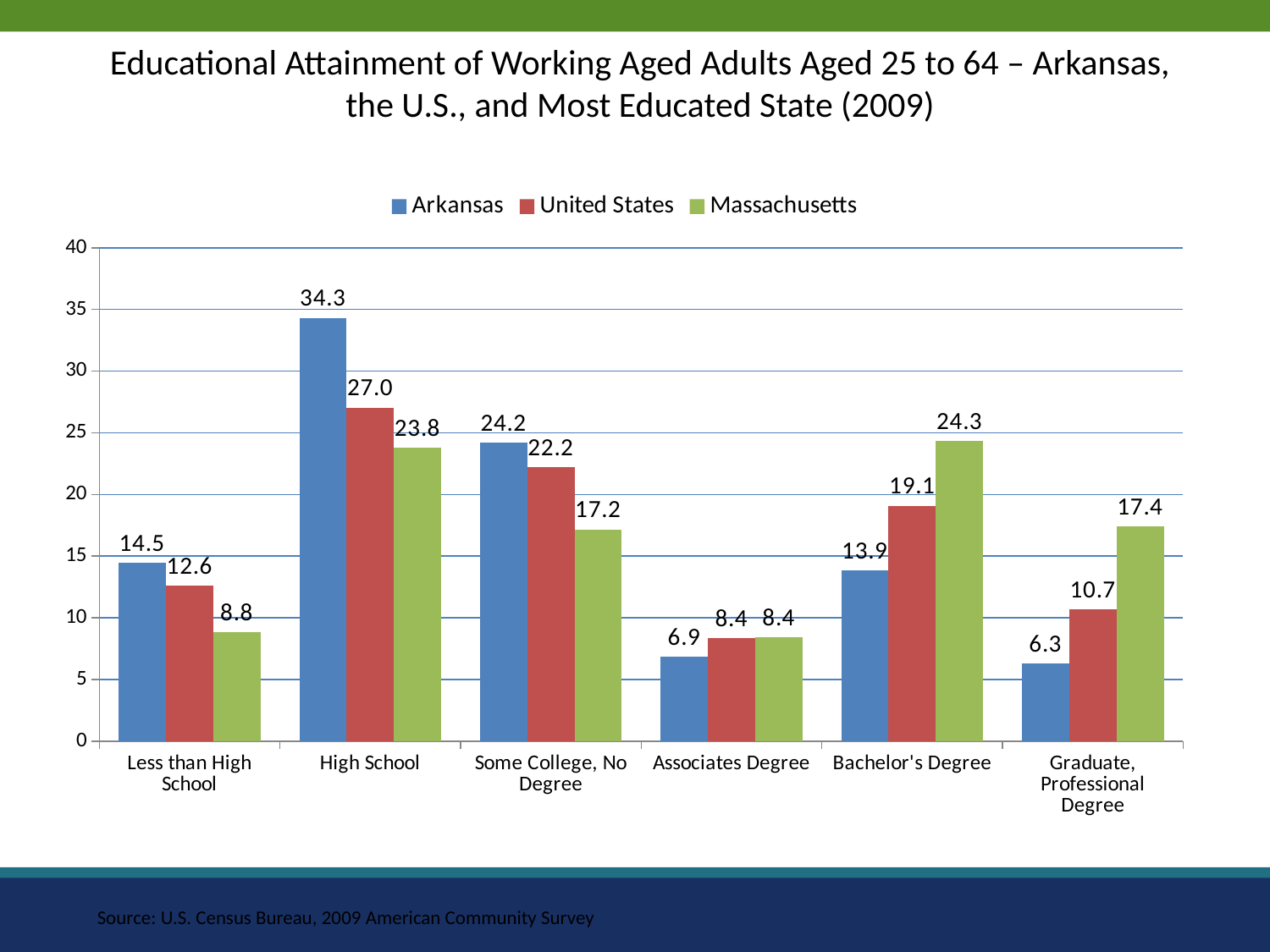
Which category has the highest value for Arkansas? High School What is the difference between the Arkansas and Massachusetts values in the Less than High School category? 5.7 What is the value for Massachusetts in the Bachelor's Degree category? 24.3 What is the value for Arkansas in the High School category? 34.3 How many series does the legend list? 3 Is the value for Massachusetts in the Graduate, Professional Degree category greater or less than 15? greater What kind of chart is shown on the slide? Bar chart Which is larger in the Some College, No Degree category: Arkansas or the United States? Arkansas What is the value for the United States in the Graduate, Professional Degree category? 10.7 Which category has the lowest value for Massachusetts? Associates Degree Which series is shown in green in the legend? Massachusetts How many education categories are shown on the x axis? 6